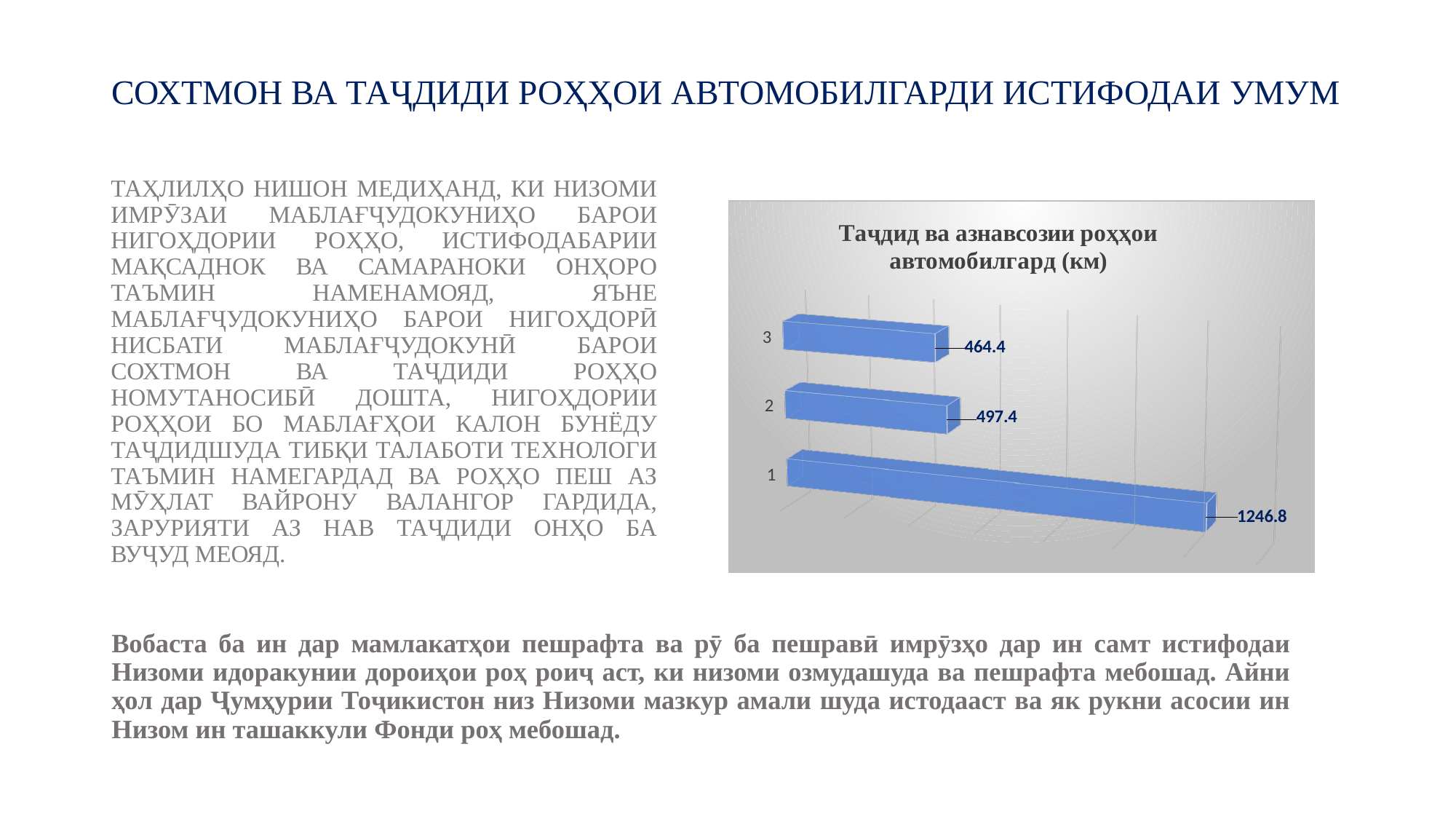
What is the value for category 1 in the chart? 1246.8 Which is larger, the value for category 2 or the value for category 3? category 2 Which category has the highest value in the chart? 1 What is the difference between the values for category 1 and category 2? 749.4 What is the difference between the values for category 2 and category 3? 33.0 What is the value for category 2 in the chart? 497.4 What unit is given in the chart title? км What kind of chart is shown on the slide? bar chart How many categories are shown in the chart? 3 What is the value for category 3 in the chart? 464.4 Which category has the lowest value in the chart? 3 What is the title of the chart? Таҷдид ва азнавсозии роҳҳои автомобилгард (км)